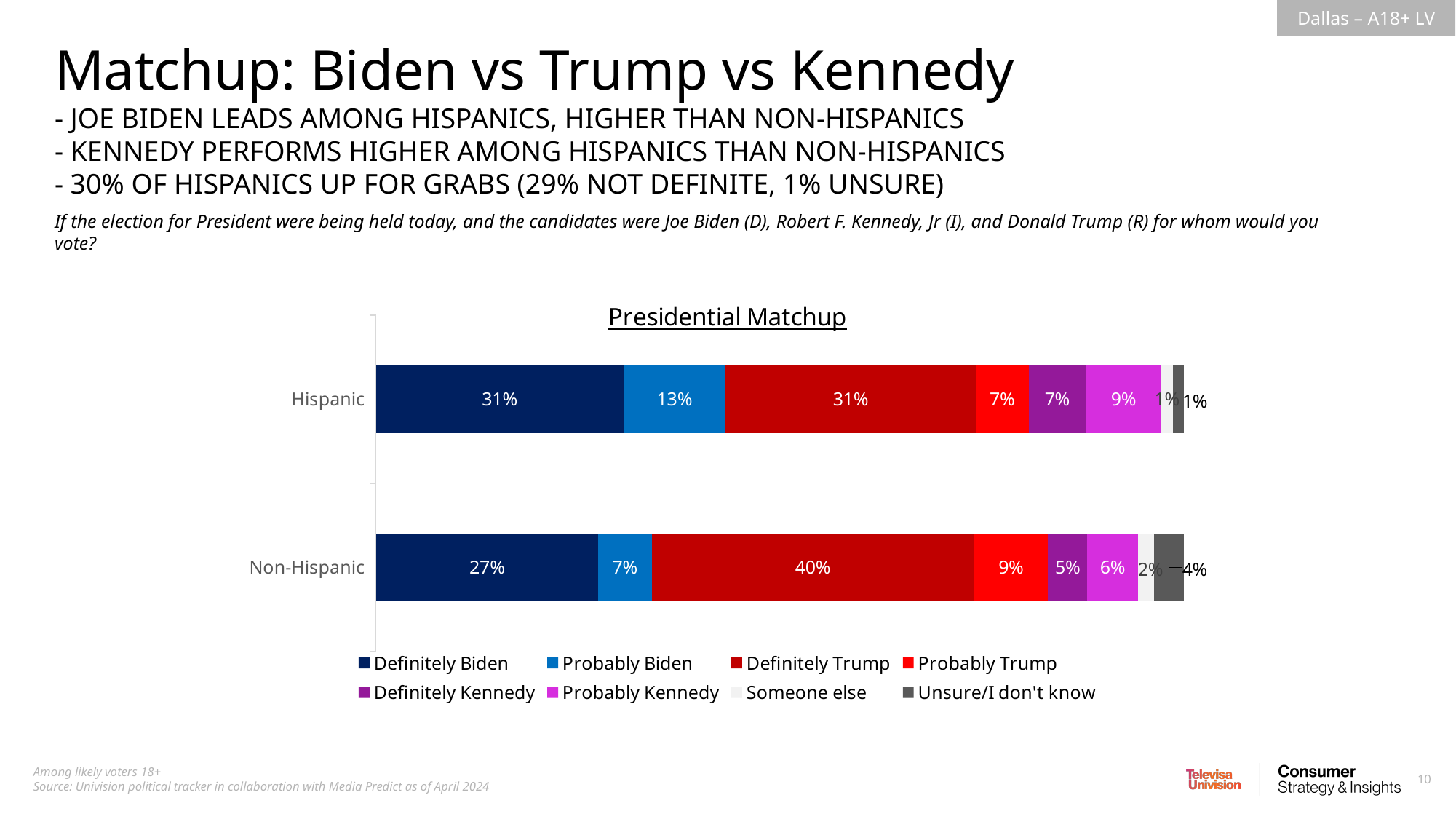
What is the difference between the Definitely Trump values for Non-Hispanic and Hispanic voters? 9% What is the title of the chart? Presidential Matchup Which series has the largest value in the Non-Hispanic bar? Definitely Trump What is the Unsure/I don't know value for Non-Hispanic voters? 4% How many categories are shown on the chart? 2 Which category has the higher Definitely Trump value, Hispanic or Non-Hispanic? Non-Hispanic How many series does the legend list? 8 What percentage of Hispanic likely voters said Definitely Biden? 31% What percentage of Non-Hispanic likely voters said Definitely Trump? 40% What kind of chart is shown on the slide? Stacked bar chart What is the difference between the Probably Biden values for Hispanic and Non-Hispanic voters? 6% What is the Probably Kennedy value for Hispanic voters? 9%